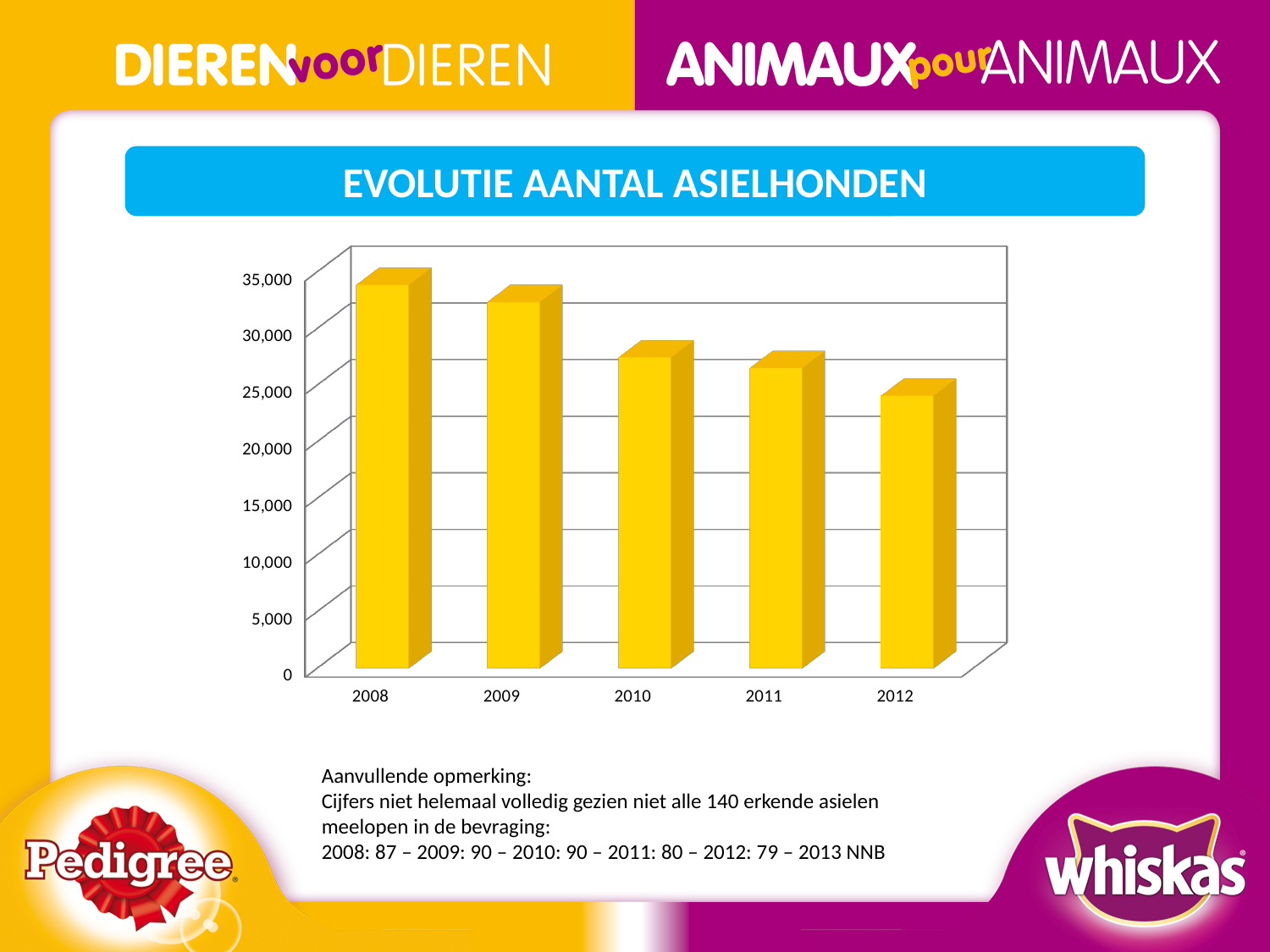
Is the value for 2008 greater or less than 30,000? greater How many years are shown on the x axis of the chart? 5 Is the value for 2010 greater or less than 30,000? less Which year has the larger value, 2008 or 2012? 2008 Do the values rise or fall from 2008 to 2012? fall Which year has the highest bar in the chart? 2008 Is the value for 2009 greater or less than 30,000? greater Which year has the lowest bar in the chart? 2012 What is the title of the chart? EVOLUTIE AANTAL ASIELHONDEN Which year has the larger value, 2009 or 2011? 2009 What kind of chart is shown on the slide? bar chart